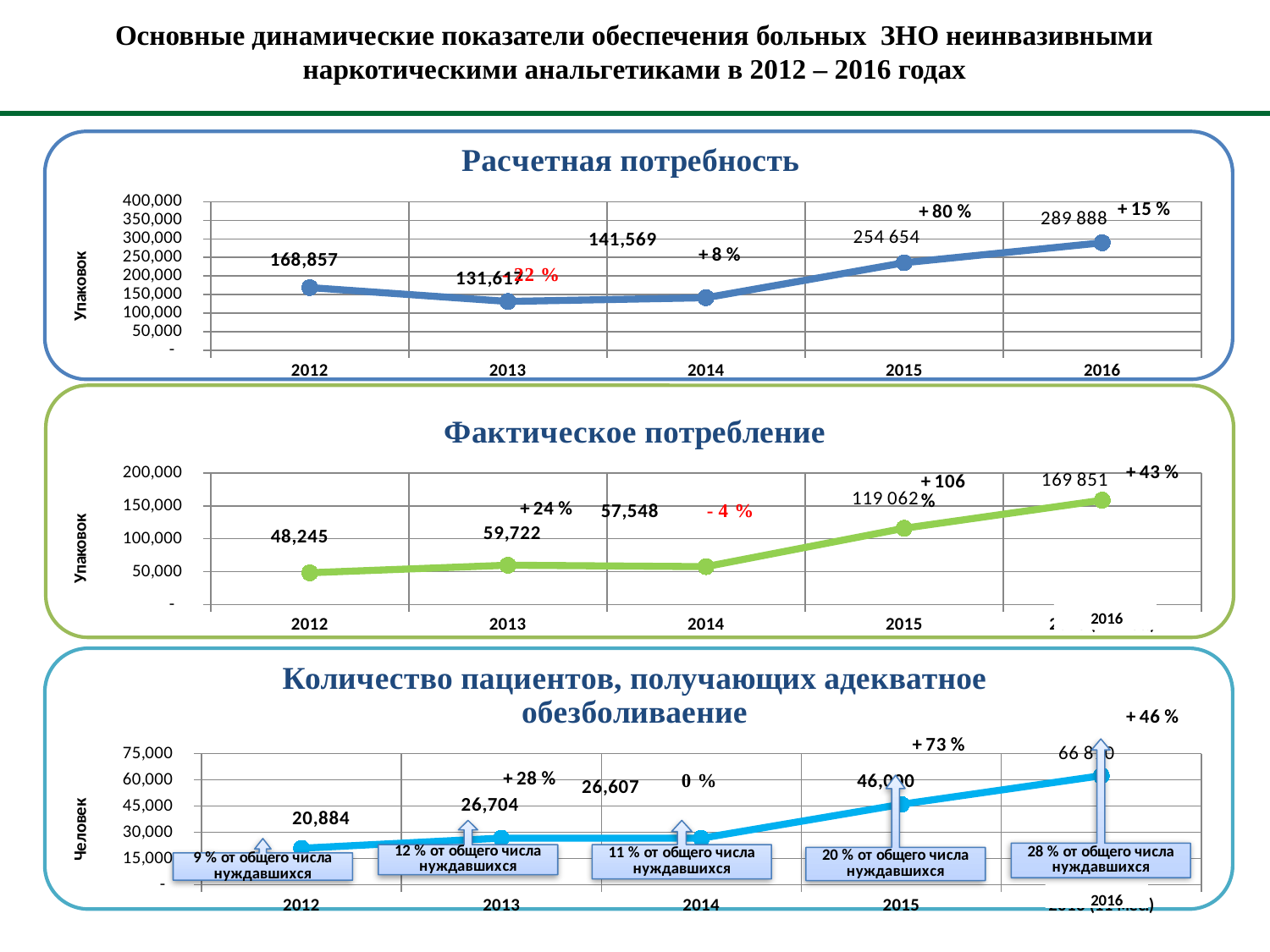
How many data points (years) are plotted in the 'Расчетная потребность' chart? 5 In the 'Расчетная потребность' chart, what is the value for 2012? 168,857 In the 'Фактическое потребление' chart, is the value for 2015 greater or less than 100,000? greater In the 'Расчетная потребность' chart, what is the difference between the 2016 and 2015 values? 35 234 In the 'Расчетная потребность' chart, which year has the highest value? 2016 In the 'Фактическое потребление' chart, what percentage change is shown between 2015 and 2016? +43 % In the 'Количество пациентов, получающих адекватное обезболивание' chart, what is the value for 2012? 20,884 What type of chart is the 'Фактическое потребление' chart? line chart In the 'Фактическое потребление' chart, which year has the lowest value? 2012 In the 'Фактическое потребление' chart, what is the value for 2013? 59,722 In the 'Количество пациентов, получающих адекватное обезболивание' chart, which is larger, the value for 2013 or the value for 2012? 2013 In the 'Расчетная потребность' chart, what is the value for 2016? 289 888